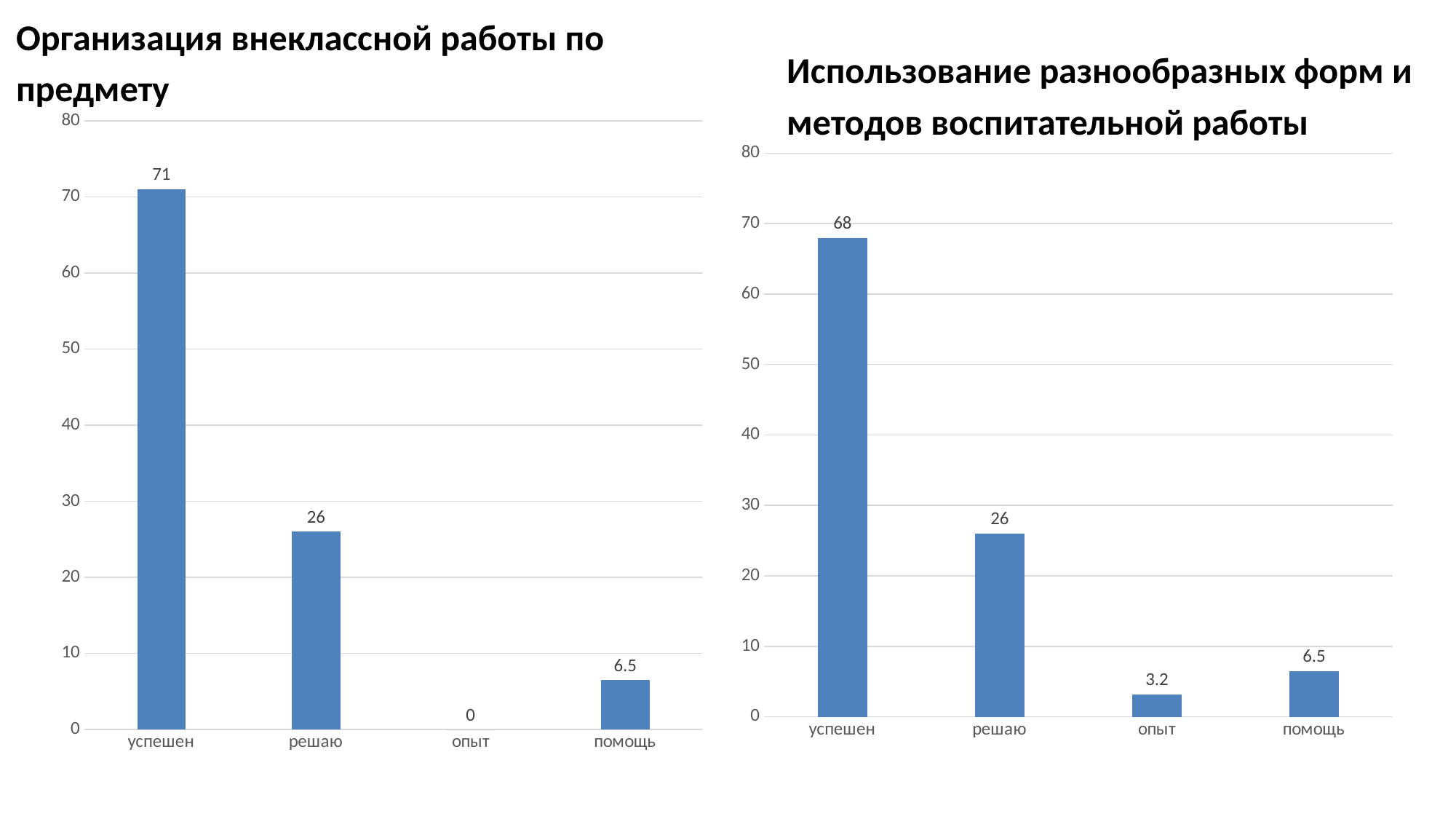
What kind of chart is the right chart 'Использование разнообразных форм и методов воспитательной работы'? bar chart In the right chart 'Использование разнообразных форм и методов воспитательной работы', what is the difference between the values for 'помощь' and 'опыт'? 3.3 In the left chart 'Организация внеклассной работы по предмету', what is the value for 'опыт'? 0 In the right chart 'Использование разнообразных форм и методов воспитательной работы', which is larger, the value for 'решаю' or the value for 'помощь'? решаю In the left chart 'Организация внеклассной работы по предмету', what is the difference between the values for 'успешен' and 'решаю'? 45 In the left chart 'Организация внеклассной работы по предмету', what is the value for 'успешен'? 71 In the right chart 'Использование разнообразных форм и методов воспитательной работы', what is the value for 'успешен'? 68 How many categories are shown on the x axis of the left chart 'Организация внеклассной работы по предмету'? 4 In the right chart 'Использование разнообразных форм и методов воспитательной работы', what is the value for 'опыт'? 3.2 In the right chart 'Использование разнообразных форм и методов воспитательной работы', which category has the lowest value? опыт Is the value for 'успешен' in the left chart 'Организация внеклассной работы по предмету' greater or less than 70? greater In the left chart 'Организация внеклассной работы по предмету', which category has the highest value? успешен